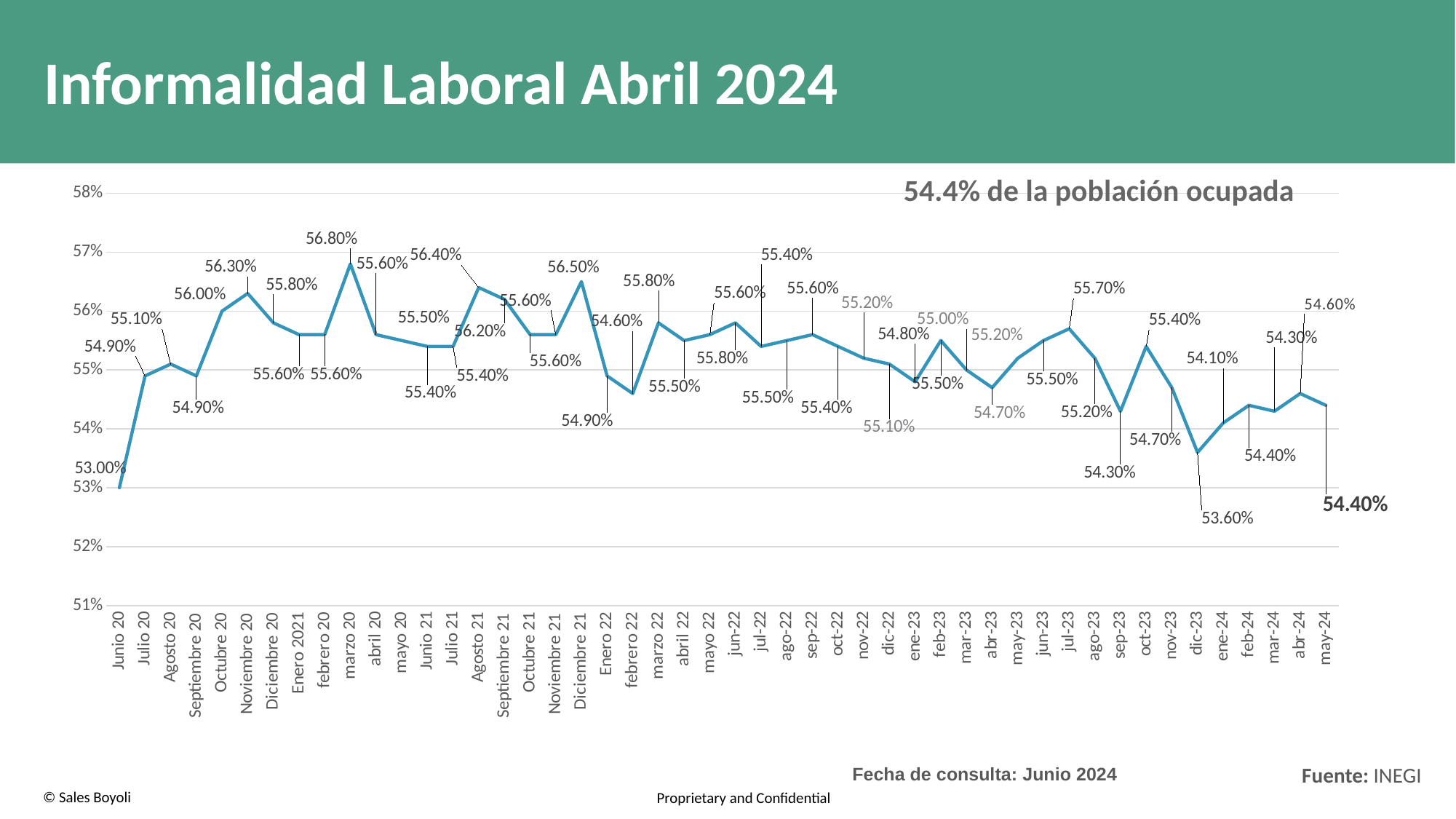
What is the value for may-24? 54.40% What is the difference between the value for abr-24 and the value for may-24? 0.20 percentage points Which month has the lowest informality rate on the chart? Junio 20 What kind of chart is shown on the slide? Line chart What is the value for dic-23? 53.60% Which month has the highest informality rate on the chart? marzo 20 Is the value for Diciembre 21 greater or less than 56%? greater How many months are plotted on the x axis? 48 What source is cited for the chart data? INEGI What is the value for marzo 20? 56.80% Which is larger, the value for abr-24 or the value for mar-24? abr-24 What is the difference between the value for marzo 20 and the value for Junio 20? 3.80 percentage points